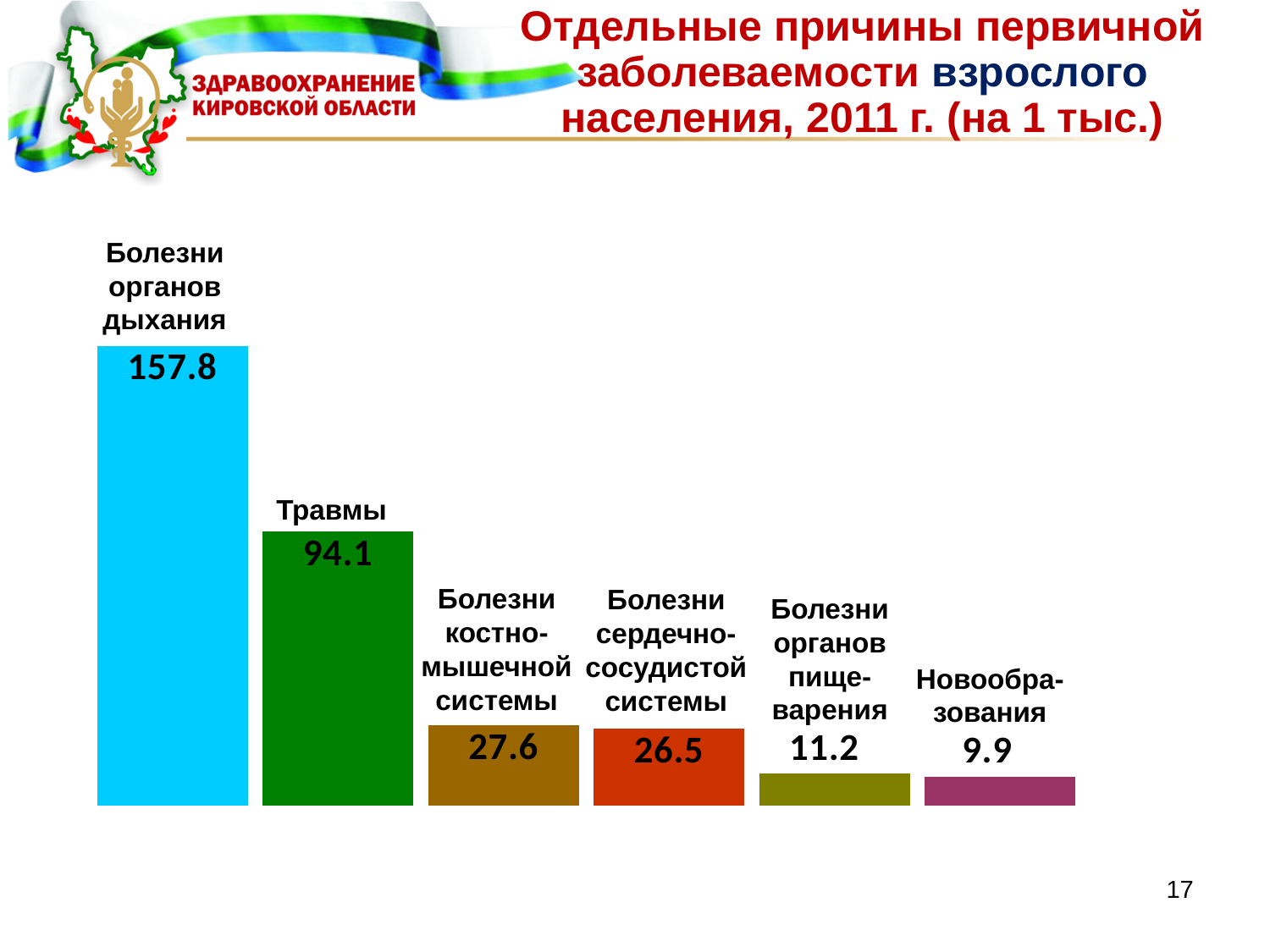
Which category has the highest value? Болезни органов дыхания What kind of chart is shown on the slide? bar chart Which category has the lowest value? Новообразования What is the difference between the values for Болезни органов дыхания and Травмы? 63.7 What is the value for Болезни костно-мышечной системы? 27.6 What is the value for Новообразования? 9.9 What is the difference between the values for Болезни органов пищеварения and Новообразования? 1.3 What is the value for Травмы? 94.1 How many categories are shown in the chart? 6 Which is larger: the value for Травмы or the value for Болезни сердечно-сосудистой системы? Травмы Do the values rise or fall from left to right across the chart? fall What is the value for Болезни органов дыхания? 157.8